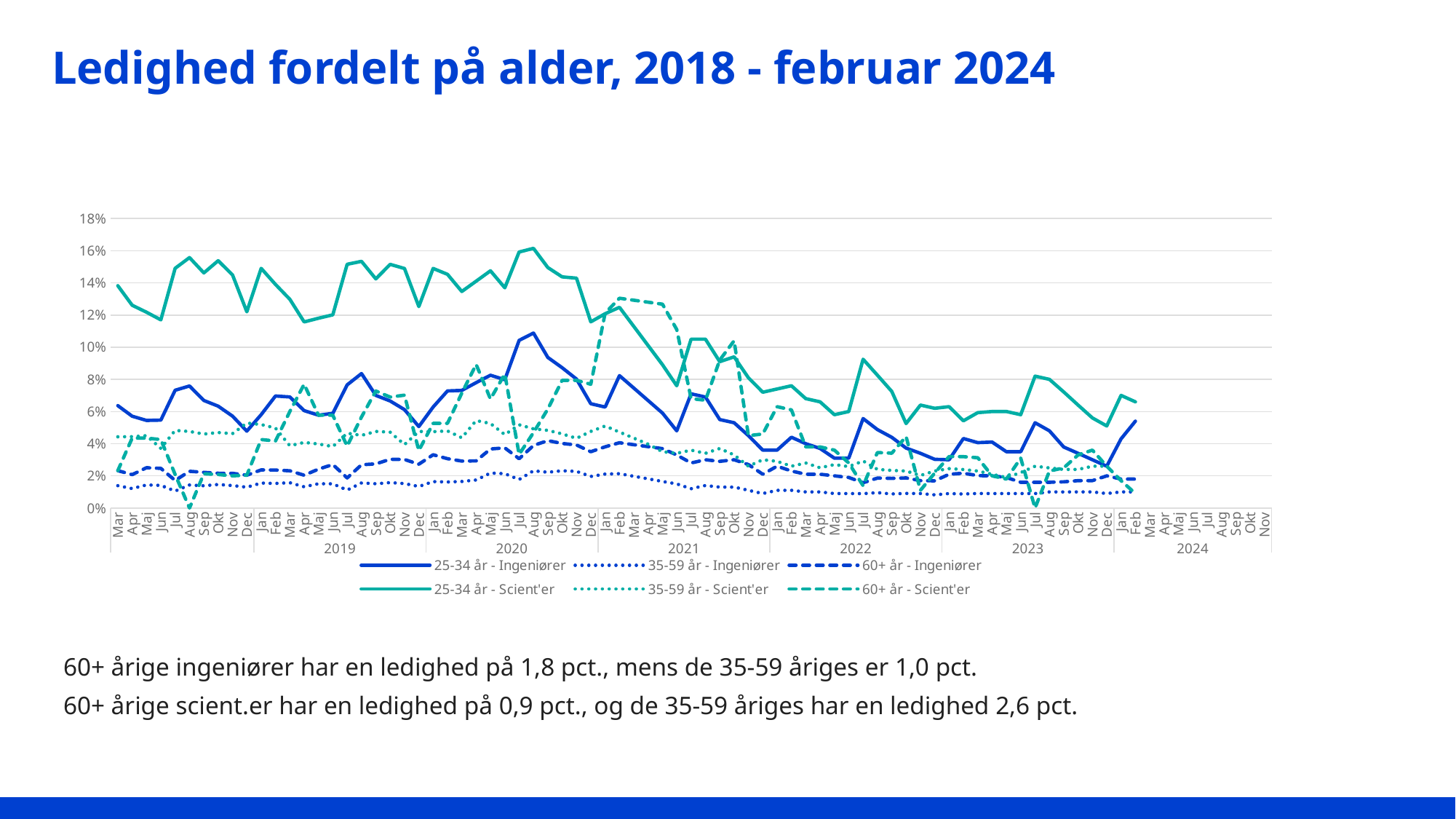
Is the value for 25-34 år - Ingeniører in Aug 2020 greater or less than 8%? greater According to the text on the slide, what is the unemployment rate for 35-59 årige scient.er? 2,6 pct. Which series has the highest values throughout 2019? 25-34 år - Scient'er Is the value for 35-59 år - Ingeniører in Jul 2023 greater or less than 2%? less Is the value for 25-34 år - Scient'er in Aug 2020 greater or less than 14%? greater What is the highest value shown on the vertical axis? 18% According to the text on the slide, which group has the higher unemployment rate: 60+ årige ingeniører or 35-59 årige ingeniører? 60+ årige ingeniører According to the text on the slide, what is the unemployment rate for 60+ årige ingeniører? 1,8 pct. Does the 25-34 år - Scient'er line generally rise or fall from early 2021 to the end of 2023? Fall How many series does the legend list? 6 What kind of chart is shown on the slide? Line chart What is the title of the chart on the slide? Ledighed fordelt på alder, 2018 - februar 2024